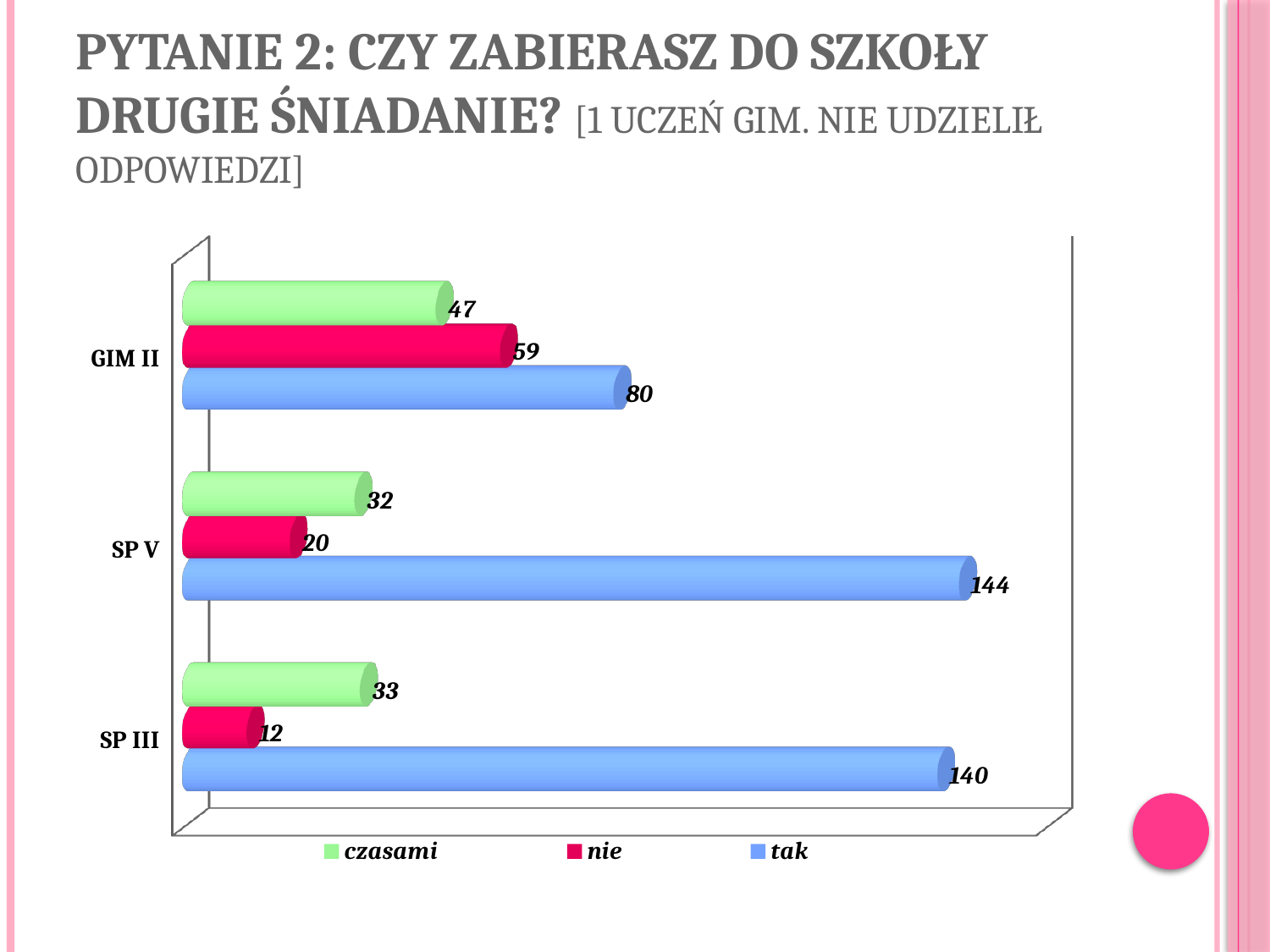
What is the difference between the "tak" values for SP V and GIM II? 64 What is the value for "tak" in the SP V category? 144 Which category has the highest value for "tak"? SP V Which category has the lowest value for "nie"? SP III What is the value for "czasami" in the SP III category? 33 What kind of chart is shown on the slide? bar chart How many categories are shown on the chart? 3 How many series does the legend list? 3 What is the total of the three values for the SP III category? 185 What is the value for "nie" in the GIM II category? 59 Which colour represents the "nie" series in the legend? pink/red Which is larger: the "czasami" value for GIM II or the "czasami" value for SP V? GIM II